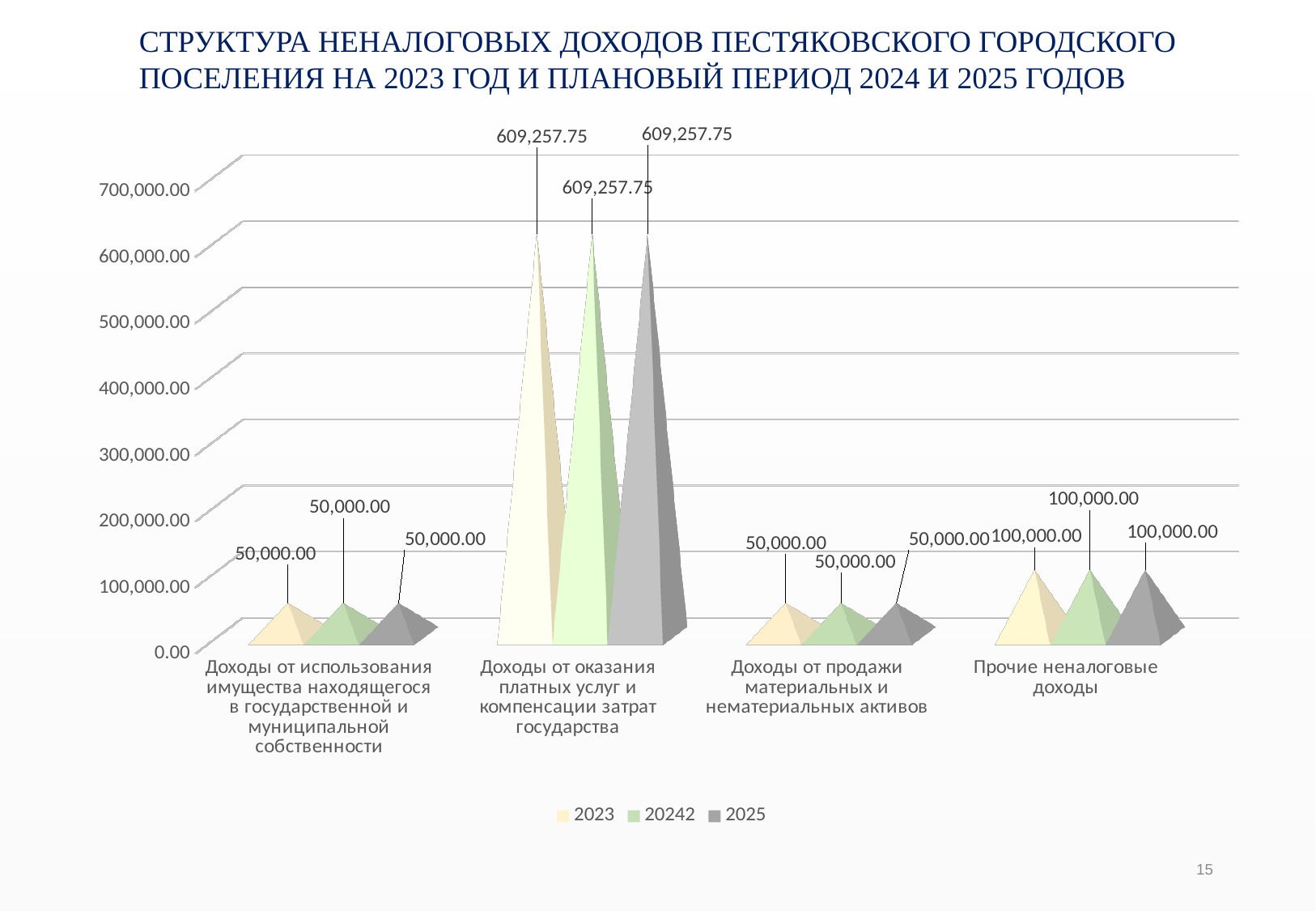
What are the legend entries of the chart? 2023, 20242, 2025 What is the difference between the 2025 value for "Прочие неналоговые доходы" and the 2025 value for "Доходы от продажи материальных и нематериальных активов"? 50,000.00 Which is larger: the 2023 value for "Прочие неналоговые доходы" or the 2023 value for "Доходы от использования имущества находящегося в государственной и муниципальной собственности"? Прочие неналоговые доходы Is the 2025 value for "Доходы от оказания платных услуг и компенсации затрат государства" greater or less than 500,000.00? greater How many categories are shown on the x axis? 4 How many series does the legend list? 3 What is the value for 2025 in the category "Прочие неналоговые доходы"? 100,000.00 What is the value for 2023 in the category "Доходы от продажи материальных и нематериальных активов"? 50,000.00 Which category has the highest value for 2025? Доходы от оказания платных услуг и компенсации затрат государства What kind of chart is shown on the slide? bar chart What is the value for 2023 in the category "Доходы от оказания платных услуг и компенсации затрат государства"? 609,257.75 What is the difference between the 2023 value for "Доходы от оказания платных услуг и компенсации затрат государства" and the 2023 value for "Прочие неналоговые доходы"? 509,257.75